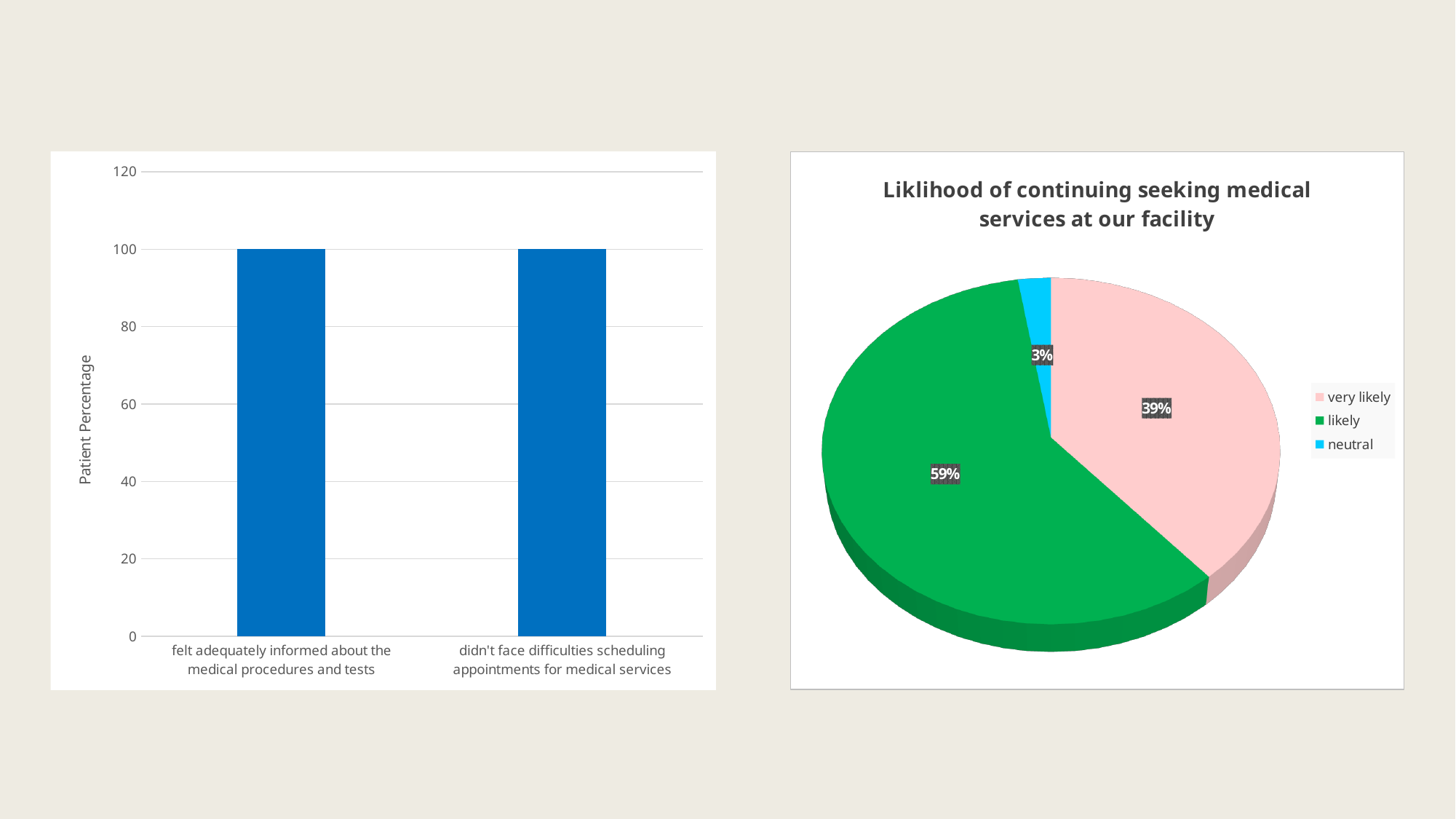
In the bar chart on the left, what is the label of the vertical axis? Patient Percentage In the bar chart on the left, what is the value for 'didn't face difficulties scheduling appointments for medical services'? 100 In the bar chart on the left, how many categories are plotted? 2 In the 'Liklihood of continuing seeking medical services at our facility' chart, what share is 'neutral'? 3% What kind of chart is the chart on the left of the slide? bar chart In the bar chart on the left, what is the value for 'felt adequately informed about the medical procedures and tests'? 100 In the 'Liklihood of continuing seeking medical services at our facility' chart, what share is 'very likely'? 39% In the 'Liklihood of continuing seeking medical services at our facility' chart, what is the difference between the 'likely' and 'very likely' shares? 20% In the 'Liklihood of continuing seeking medical services at our facility' chart, which category has the smallest slice? neutral In the 'Liklihood of continuing seeking medical services at our facility' chart, which category has the largest slice? likely In the 'Liklihood of continuing seeking medical services at our facility' chart, what share is 'likely'? 59% In the bar chart on the left, is the value for 'felt adequately informed about the medical procedures and tests' greater or less than 80? greater